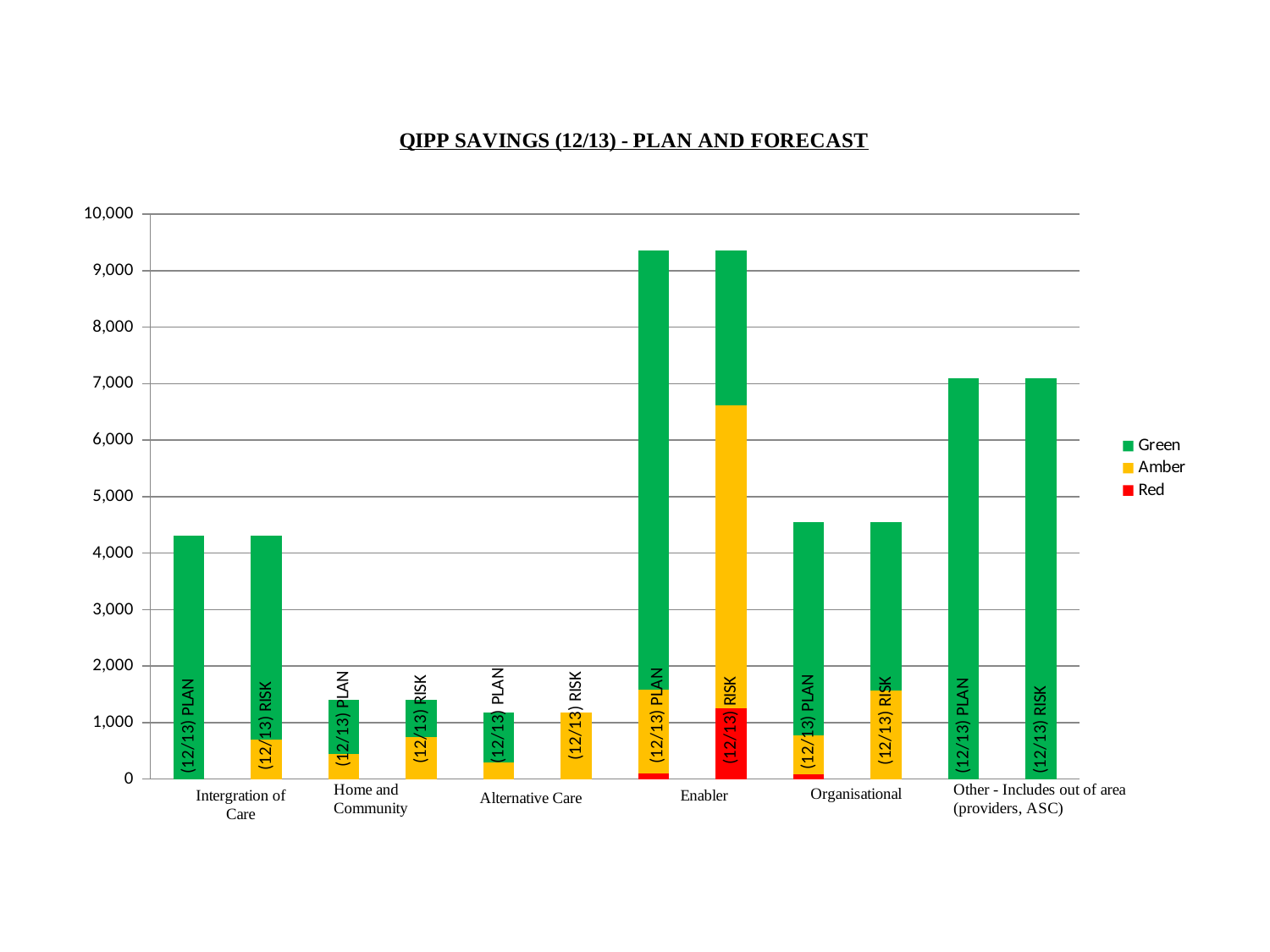
Is the value of the Enabler (12/13) PLAN bar greater or less than 9,000? greater Which category's (12/13) RISK bar contains the largest Red segment? Enabler How many bars are plotted in total on the chart? 12 Is the value of the Alternative Care (12/13) RISK bar greater or less than 2,000? less What is the title of the chart? QIPP SAVINGS (12/13) - PLAN AND FORECAST Which category has the shortest bars? Alternative Care Which category has the tallest bars? Enabler Which is larger, the Enabler (12/13) PLAN bar or the Other - Includes out of area (providers, ASC) (12/13) PLAN bar? Enabler (12/13) PLAN What kind of chart is shown on the slide? Stacked bar chart How many series does the legend list? 3 Is the value of the Integration of Care (12/13) PLAN bar greater or less than 4,000? greater How many category groups are shown along the x axis? 6